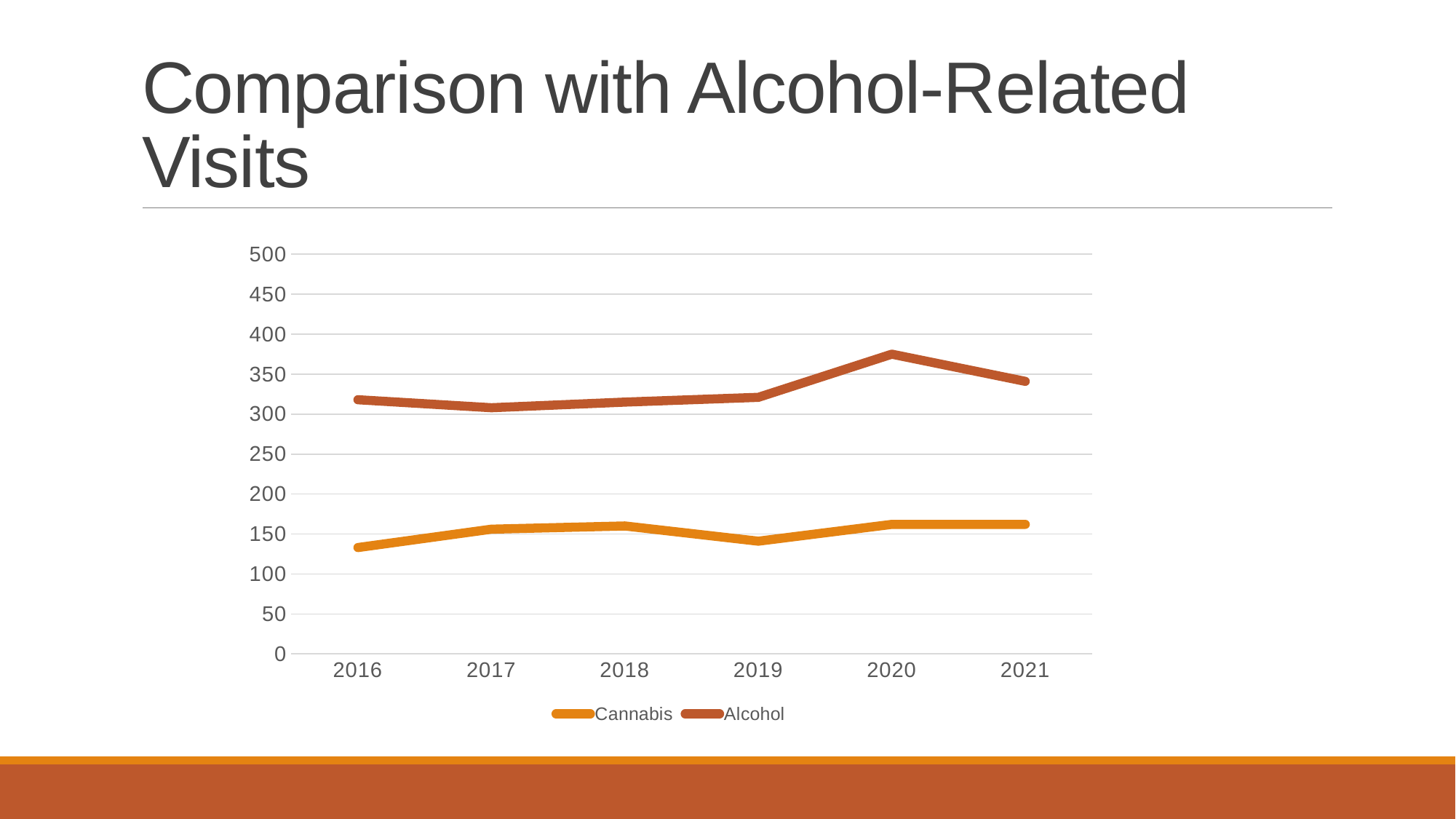
In which year does the Alcohol series reach its highest value? 2020 Is the value for Alcohol in 2020 greater or less than 350? greater Is the value for Cannabis in 2021 greater or less than 200? less In which year does the Cannabis series have its lowest value? 2016 What kind of chart is shown on the slide? line chart Which series has the higher value in 2018, Cannabis or Alcohol? Alcohol How many years are shown on the x axis? 6 Is the value for Alcohol in 2017 greater or less than 300? greater Which series is drawn in the lighter orange colour? Cannabis Does the Alcohol series rise or fall from 2019 to 2020? rise How many series does the legend list? 2